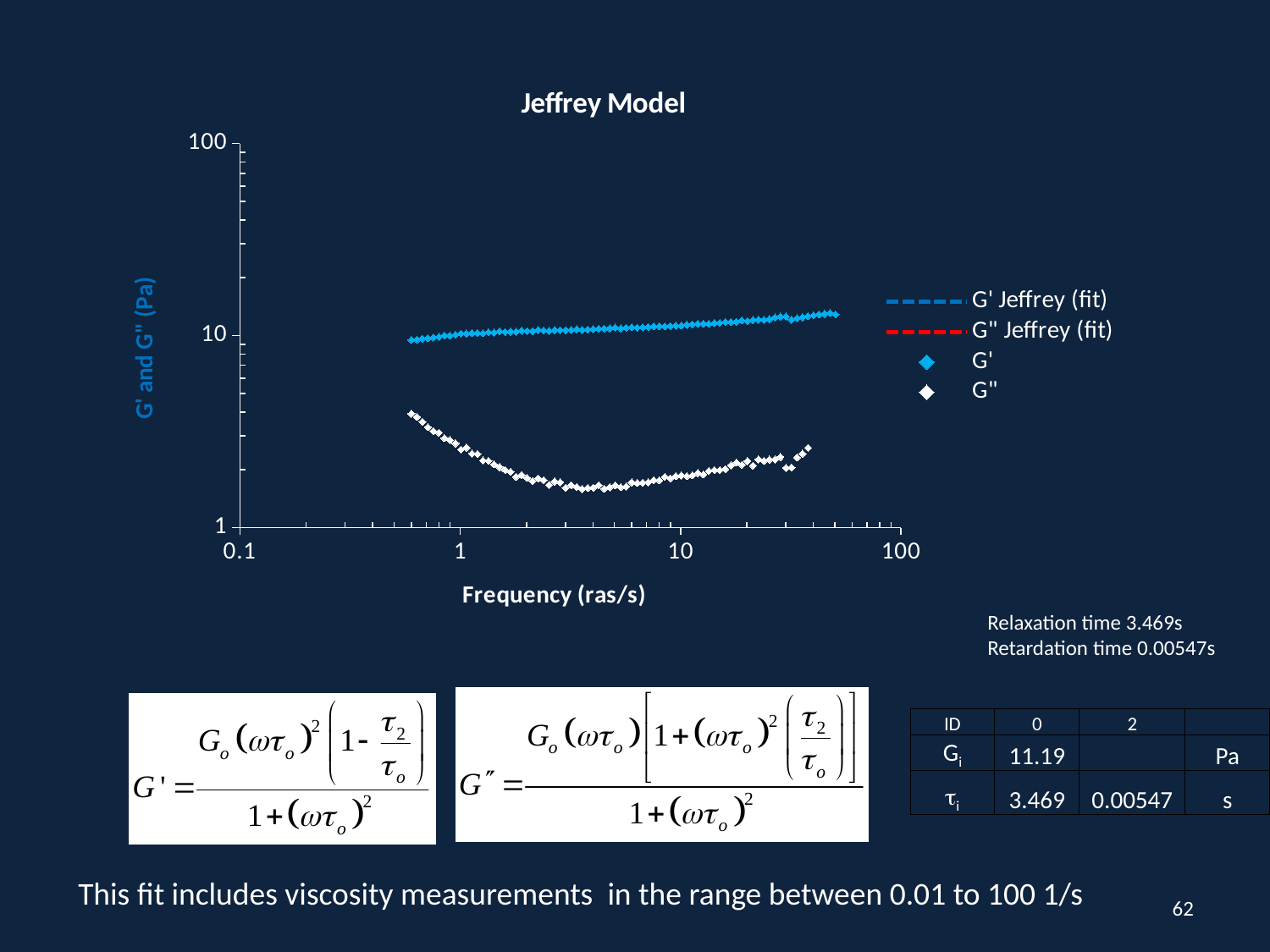
How many series does the chart legend list? 4 What is the title of the chart? Jeffrey Model At a frequency of 1 rad/s, which is larger, G' or G"? G' At a frequency of 10 rad/s, which is larger, G' or G"? G' Which series has the lowest values on the chart, G' or G"? G" Is the value of G" at a frequency of 10 rad/s greater or less than 10? less What is the label of the x axis of the chart? Frequency (ras/s) Does G" rise or fall as frequency increases from 1 to 4 rad/s? fall Does G' rise or fall as frequency increases from 1 to 50 rad/s? rise Is the value of G" at a frequency of 1 rad/s greater or less than 1? greater What kind of chart is shown on the slide? scatter chart Is the value of G' at a frequency of 10 rad/s greater or less than 100? less